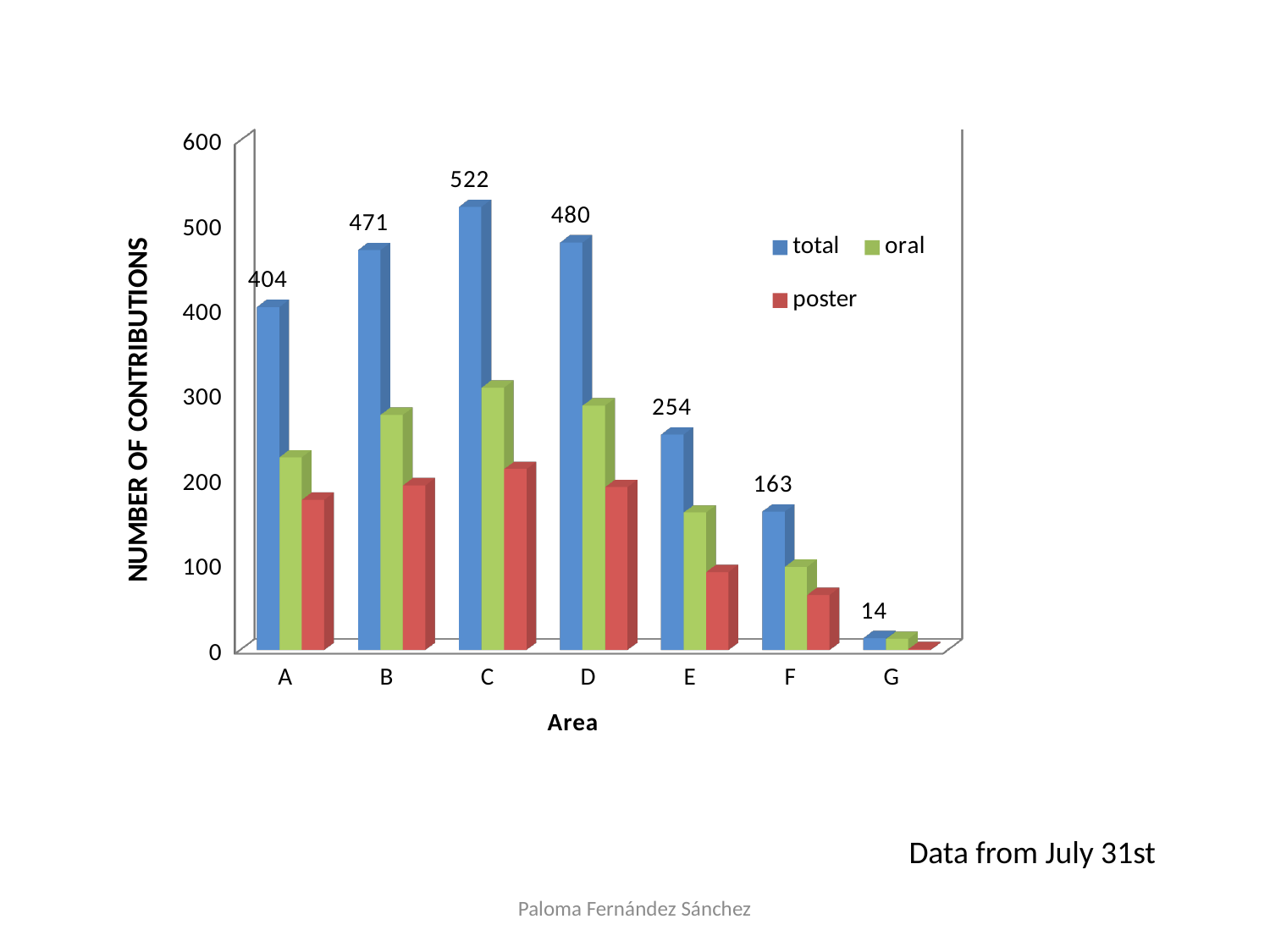
Which area has the highest total number of contributions? C What is the difference between the total contributions for Area C and Area D? 42 Which area has more total contributions, B or D? D What is the total number of contributions for Area A? 404 How many series does the legend list? 3 Is the poster value for Area E greater or less than 100? less What is the total number of contributions for Area C? 522 Which area has the lowest total number of contributions? G How many areas are shown on the x axis? 7 What is the difference between the total contributions for Area B and Area E? 217 What is the total number of contributions for Area G? 14 Is the oral value for Area C greater or less than 200? greater